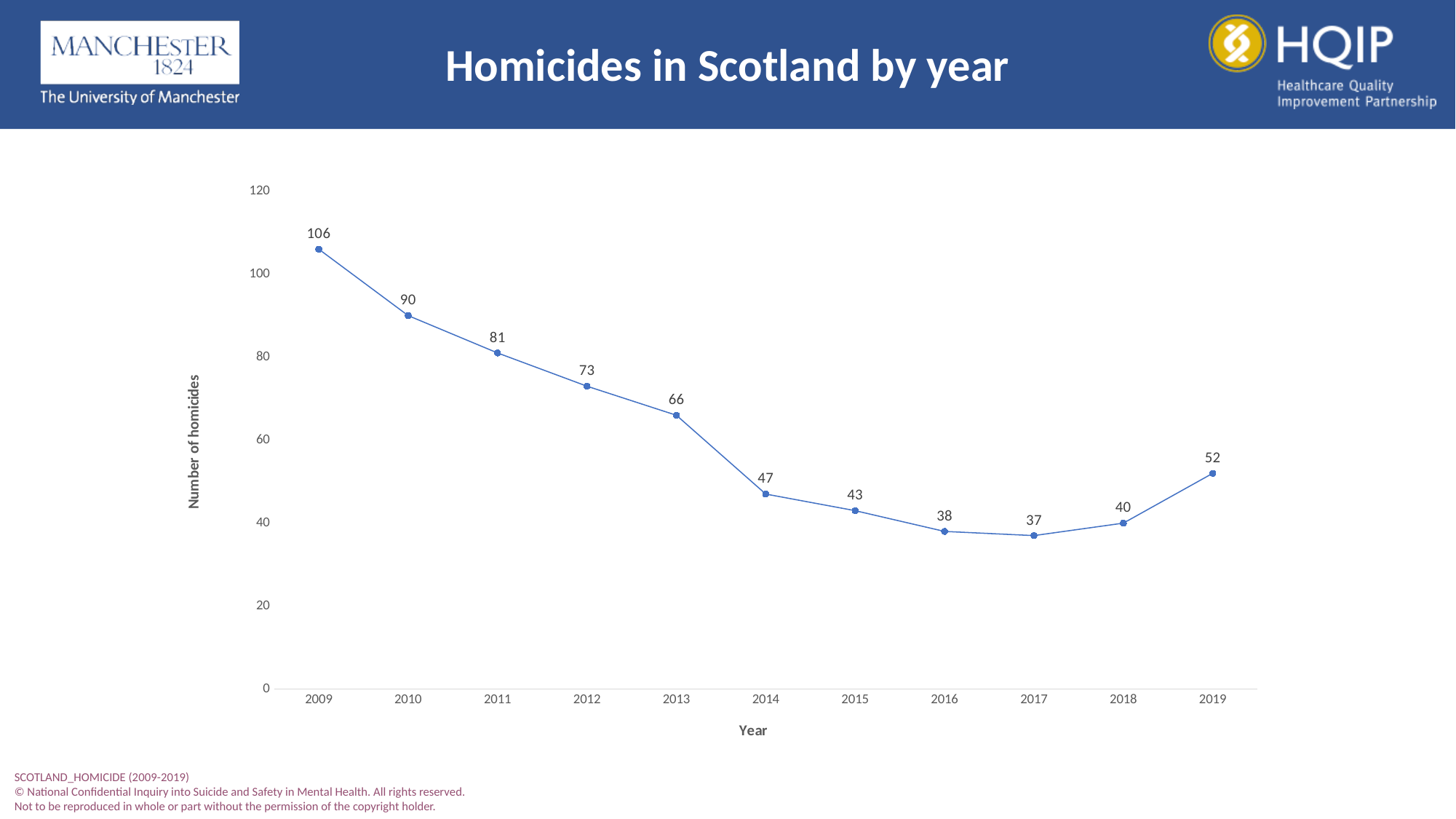
Which year has the lowest number of homicides? 2017 What is the number of homicides for 2014? 47 What is the difference in the number of homicides between 2009 and 2010? 16 Which year has the highest number of homicides? 2009 Do the number of homicides generally rise or fall from 2009 to 2017? fall What is the number of homicides for 2019? 52 What is the label of the y axis? Number of homicides What kind of chart is shown on the slide? line chart How many years are plotted on the x axis? 11 Which year had more homicides, 2018 or 2019? 2019 How many homicides were recorded in Scotland in 2009? 106 What is the difference in the number of homicides between 2013 and 2014? 19